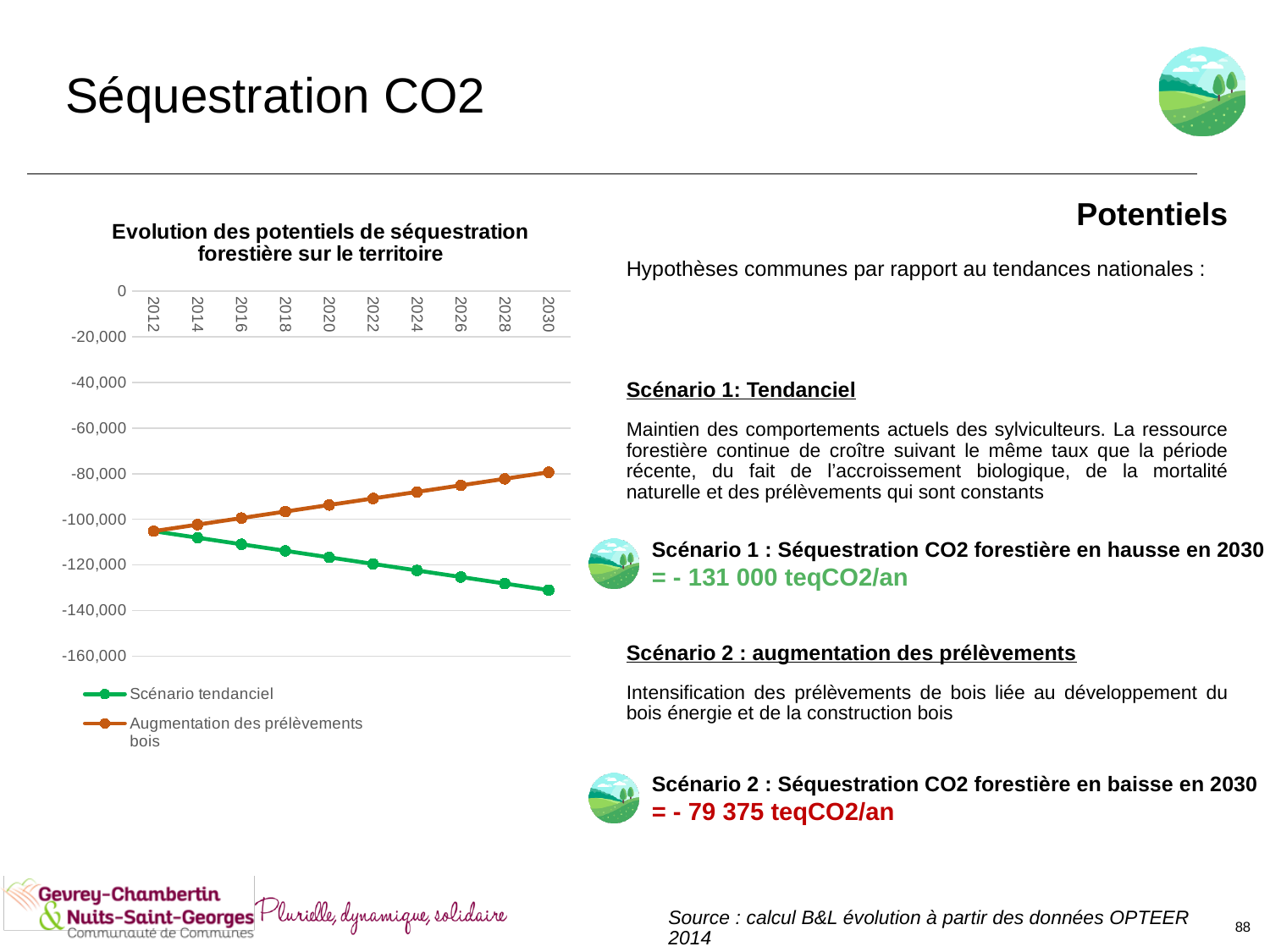
Does the 'Scénario tendanciel' series rise or fall from 2012 to 2030? fall What is the title of the chart? Evolution des potentiels de séquestration forestière sur le territoire Is the value for 'Scénario tendanciel' in 2030 greater or less than -120,000? less How many series does the chart legend list? 2 In 2030, which series has the higher value: 'Scénario tendanciel' or 'Augmentation des prélèvements bois'? Augmentation des prélèvements bois Does the 'Augmentation des prélèvements bois' series rise or fall from 2012 to 2030? rise In which year does the 'Scénario tendanciel' series reach its lowest value? 2030 In which year does the 'Augmentation des prélèvements bois' series reach its highest value? 2030 What kind of chart is shown on the slide? line chart Which colour is used for the 'Scénario tendanciel' series? green Is the value for 'Augmentation des prélèvements bois' in 2030 greater or less than -100,000? greater How many years are plotted along the x axis of the chart? 10